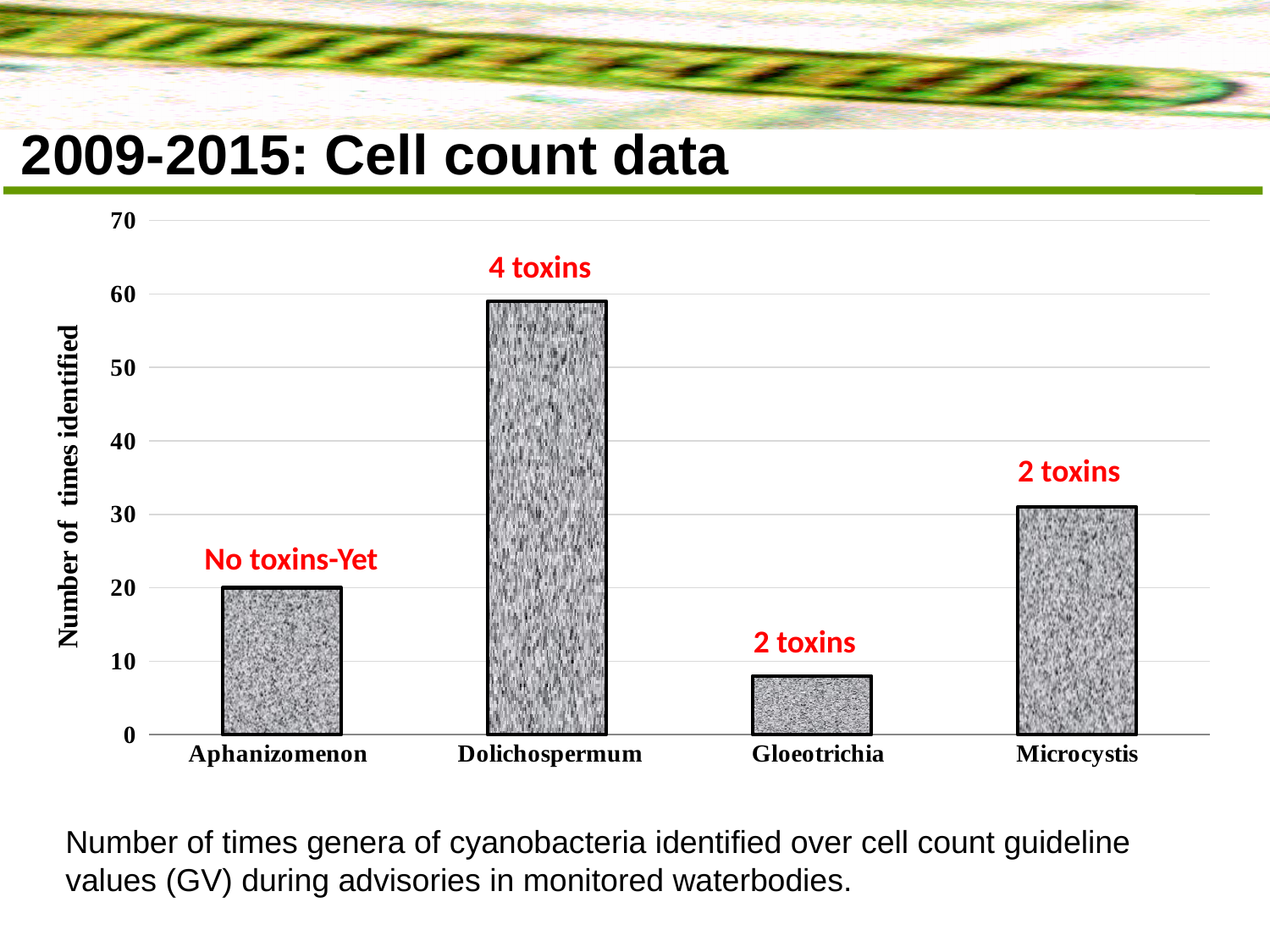
Is the value for Aphanizomenon greater or less than 30? less What kind of chart is shown on the slide? bar chart What red label is written above the Aphanizomenon bar? No toxins-Yet What red label is written above the Dolichospermum bar? 4 toxins Which genus was identified the most times? Dolichospermum How many genera (categories) are plotted on the x axis? 4 Which was identified more times, Aphanizomenon or Gloeotrichia? Aphanizomenon Is the value for Microcystis greater or less than 40? less Is the value for Gloeotrichia greater or less than 10? less Which was identified more times, Microcystis or Aphanizomenon? Microcystis Which genus was identified the fewest times? Gloeotrichia